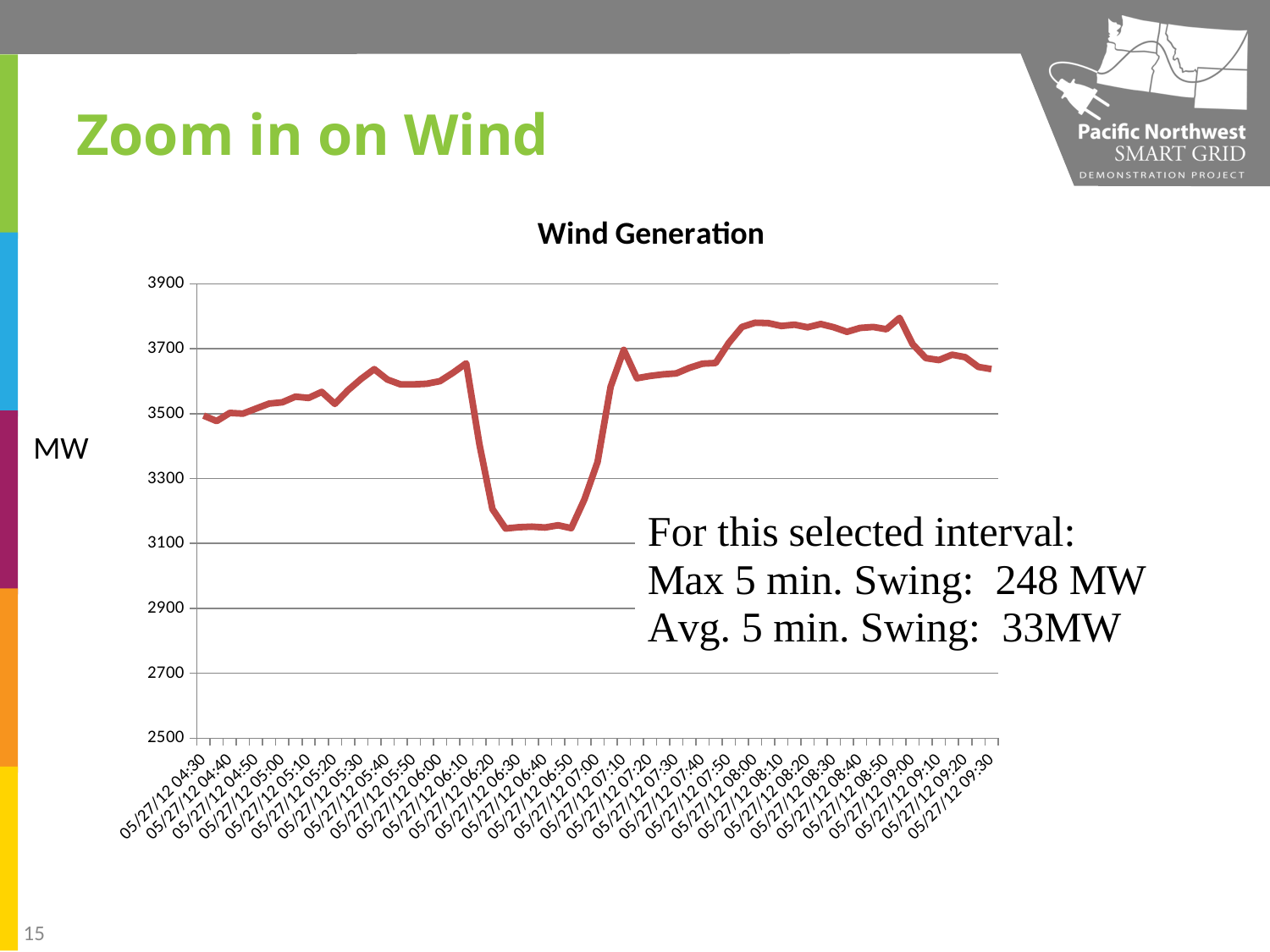
What is the title of the chart? Wind Generation What unit is shown on the y axis of the chart? MW What kind of chart is shown on the slide? line chart Does the line rise or fall between 05/27/12 06:50 and 05/27/12 07:10? rise Is the value for 05/27/12 09:30 greater or less than 3700? less Does the line rise or fall between 05/27/12 06:10 and 05/27/12 06:30? fall Is the value for 05/27/12 06:30 greater or less than 3300? less Which is larger, the value at 05/27/12 08:00 or the value at 05/27/12 06:30? 05/27/12 08:00 Is the value for 05/27/12 06:40 greater or less than 3500? less How many time labels are shown on the x axis of the chart? 31